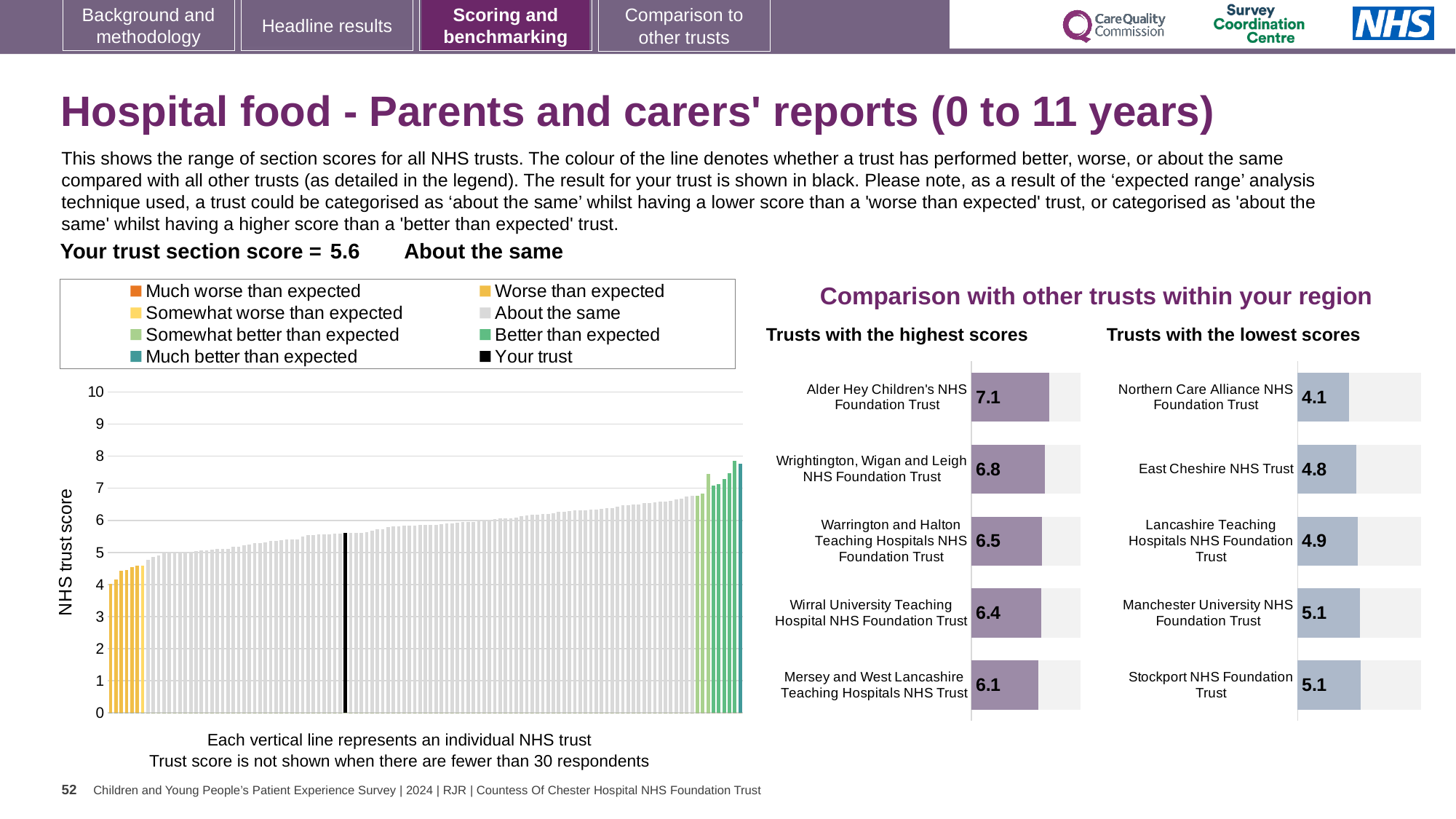
In the 'Trusts with the highest scores' chart, what is the score for Wirral University Teaching Hospital NHS Foundation Trust? 6.4 In the 'Trusts with the lowest scores' chart, what is the score for East Cheshire NHS Trust? 4.8 In the 'Trusts with the highest scores' chart, what is the score for Alder Hey Children's NHS Foundation Trust? 7.1 In the 'Trusts with the lowest scores' chart, which trust has the lowest score? Northern Care Alliance NHS Foundation Trust In the 'Trusts with the highest scores' chart, which trust has the lowest score? Mersey and West Lancashire Teaching Hospitals NHS Trust In the NHS trust score chart on the left, do the bar values rise or fall from left to right? rise In the 'Trusts with the lowest scores' chart, what is the difference between the scores of East Cheshire NHS Trust and Northern Care Alliance NHS Foundation Trust? 0.7 In the 'Trusts with the highest scores' chart, which has a higher score: Wrightington, Wigan and Leigh NHS Foundation Trust or Warrington and Halton Teaching Hospitals NHS Foundation Trust? Wrightington, Wigan and Leigh NHS Foundation Trust In the NHS trust score chart on the left, what is the section score for your trust (the black bar)? 5.6 How many trusts are shown in the 'Trusts with the lowest scores' chart? 5 How many entries does the legend of the NHS trust score chart on the left list? 8 In the 'Trusts with the highest scores' chart, what is the difference between the scores of Alder Hey Children's NHS Foundation Trust and Mersey and West Lancashire Teaching Hospitals NHS Trust? 1.0